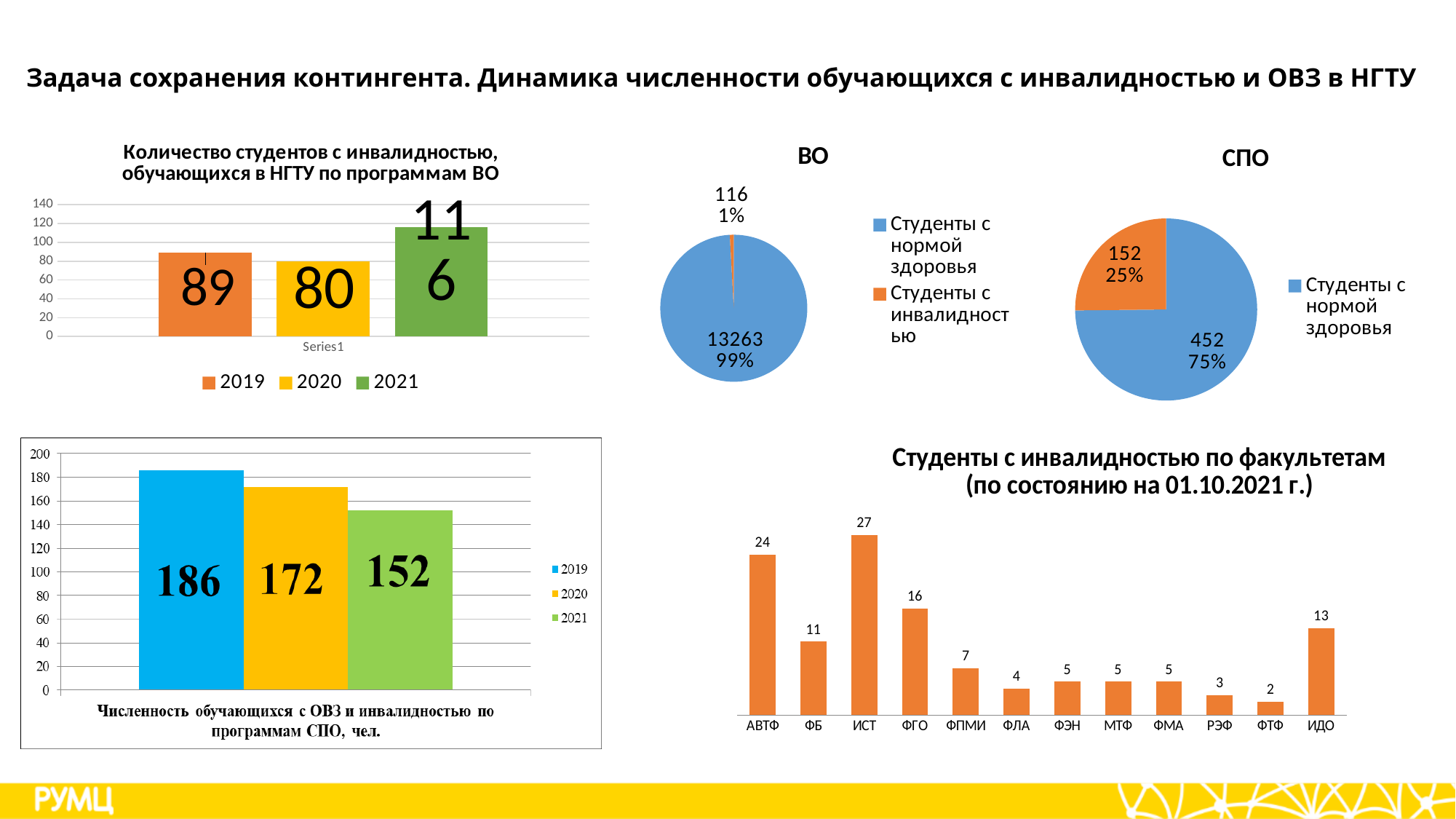
In the chart 'Численность обучающихся с ОВЗ и инвалидностью по программам СПО, чел.', what is the value for 2020? 172 In the 'ВО' pie chart, what is the value for students with normal health (Студенты с нормой здоровья)? 13263 In the chart 'Численность обучающихся с ОВЗ и инвалидностью по программам СПО, чел.', do the values rise or fall from 2019 to 2021? fall In the 'ВО' pie chart, what share of the pie do students with disabilities (Студенты с инвалидностью) make up? 1% In the chart 'Студенты с инвалидностью по факультетам', what is the value for ИДО? 13 In the chart 'Студенты с инвалидностью по факультетам', how many faculties are shown on the x axis? 12 In the chart 'Количество студентов с инвалидностью, обучающихся в НГТУ по программам ВО', which year has the lowest value? 2020 In the 'СПО' pie chart, what share of the pie does the 452 slice represent? 75% In the 'СПО' pie chart, what is the value of the orange slice? 152 In the chart 'Количество студентов с инвалидностью, обучающихся в НГТУ по программам ВО', what is the value for 2021? 116 In the chart 'Студенты с инвалидностью по факультетам', which faculty has the highest value? ИСТ In the chart 'Количество студентов с инвалидностью, обучающихся в НГТУ по программам ВО', what is the difference between the 2021 and 2019 values? 27